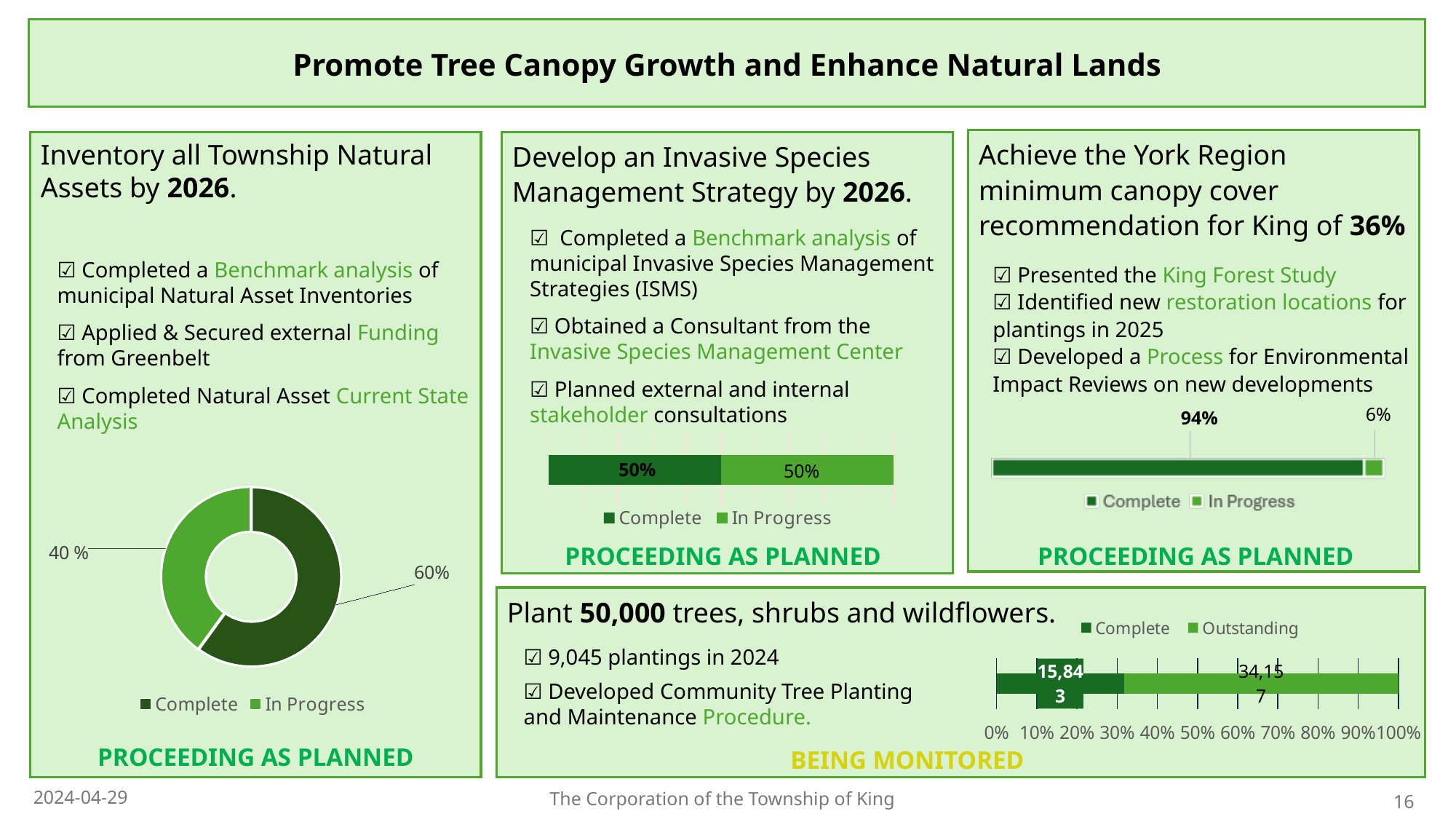
How many series does the legend list for the bar chart in the 'Develop an Invasive Species Management Strategy by 2026' panel? 2 What kind of chart is shown in the 'Inventory all Township Natural Assets by 2026' panel? Donut (pie) chart In the bar chart in the 'Develop an Invasive Species Management Strategy by 2026' panel, what value is shown for Complete? 50% In the donut chart in the 'Inventory all Township Natural Assets by 2026' panel, what share is labelled for the Complete slice? 60% In the bar chart in the 'Achieve the York Region minimum canopy cover' panel, what is the difference between the Complete and In Progress values? 88% In the bar chart in the 'Achieve the York Region minimum canopy cover' panel, what value is shown for Complete? 94% In the donut chart in the 'Inventory all Township Natural Assets by 2026' panel, which slice is larger, Complete or In Progress? Complete In the bar chart in the 'Plant 50,000 trees, shrubs and wildflowers' panel, what value is shown for Outstanding? 34,157 In the donut chart in the 'Inventory all Township Natural Assets by 2026' panel, what share is labelled for the In Progress slice? 40 % In the bar chart in the 'Achieve the York Region minimum canopy cover' panel, what value is shown for In Progress? 6% In the bar chart in the 'Plant 50,000 trees, shrubs and wildflowers' panel, what value is shown for Complete? 15,843 In the bar chart in the 'Plant 50,000 trees, shrubs and wildflowers' panel, what are the two legend entries? Complete and Outstanding